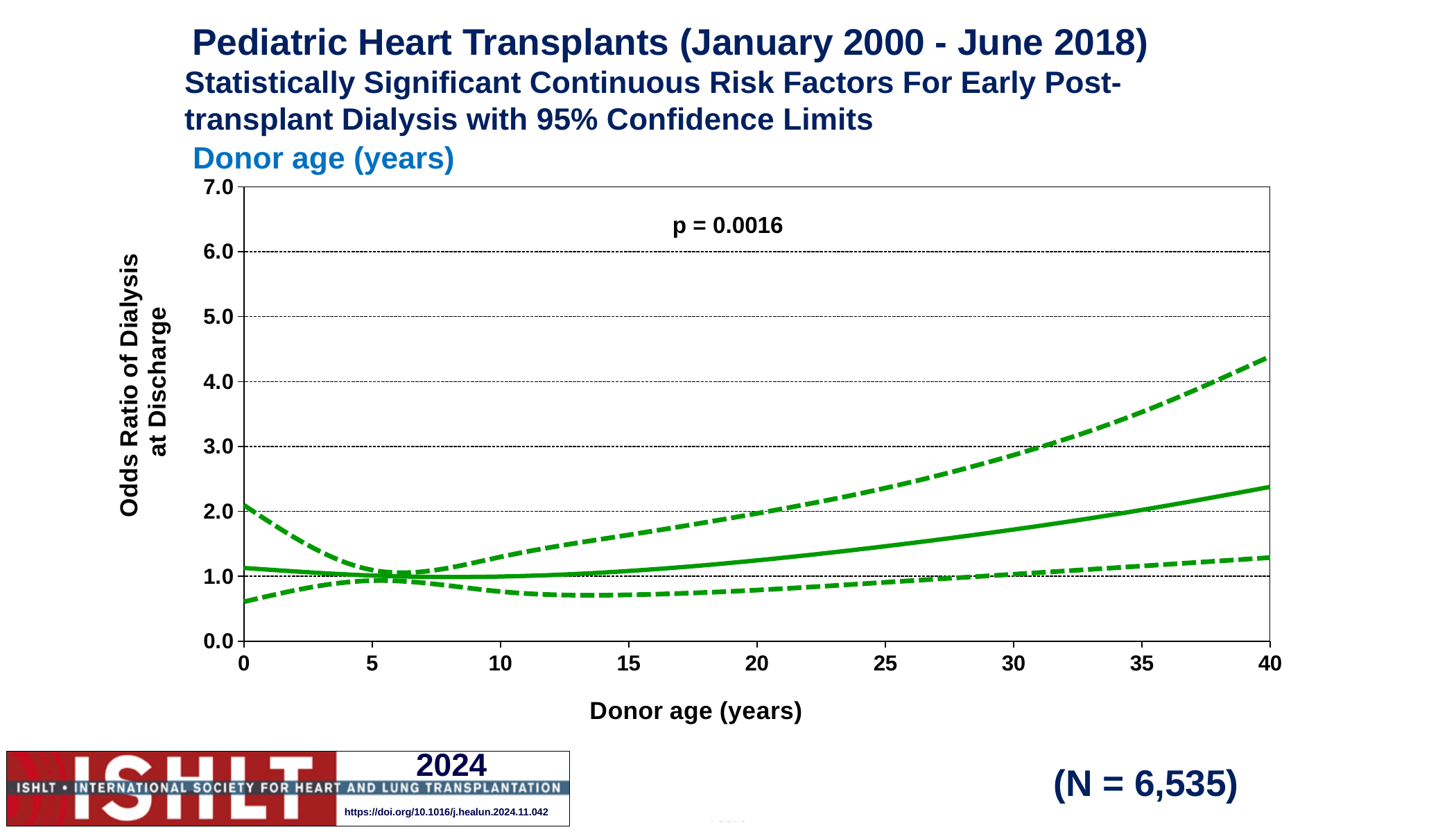
How many lines are plotted on the chart? 3 Which is larger at donor age 40: the upper dashed confidence limit or the solid odds ratio line? the upper dashed confidence limit Is the lower dashed confidence limit at donor age 40 greater or less than 2.0? less Is the upper dashed confidence limit at donor age 40 greater or less than 4.0? greater What variable is shown on the x axis of the chart? Donor age (years) Is the upper dashed confidence limit at donor age 35 greater or less than 3.0? greater What p-value is printed on the chart? p = 0.0016 Does the solid odds ratio line rise or fall overall as donor age increases from 0 to 40 years? rise What kind of chart is shown on the slide? line chart